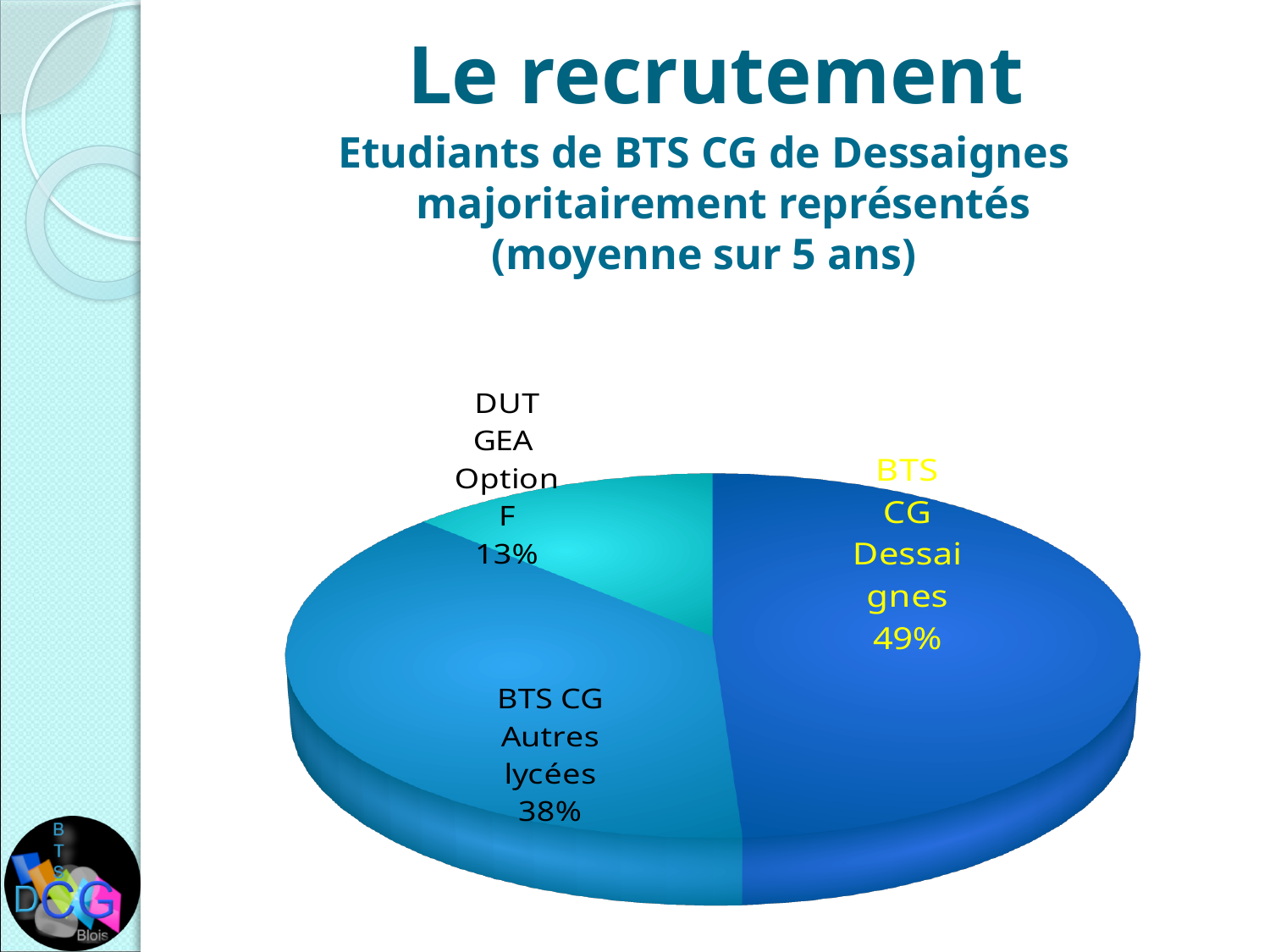
Which category has the smallest slice of the pie? DUT GEA Option F Which category has the largest slice of the pie? BTS CG Dessaignes What kind of chart is shown on the slide? Pie chart Which slice's label is written in yellow text? BTS CG Dessaignes What share of the pie does BTS CG Autres lycées represent? 38% Which is larger, the share for BTS CG Autres lycées or the share for DUT GEA Option F? BTS CG Autres lycées What is the difference in percentage points between BTS CG Dessaignes and BTS CG Autres lycées? 11 What is the main title of the slide? Le recrutement What share of the pie does BTS CG Dessaignes represent? 49% What share of the pie does DUT GEA Option F represent? 13% What is the difference in percentage points between BTS CG Autres lycées and DUT GEA Option F? 25 How many slices does the pie chart have? 3